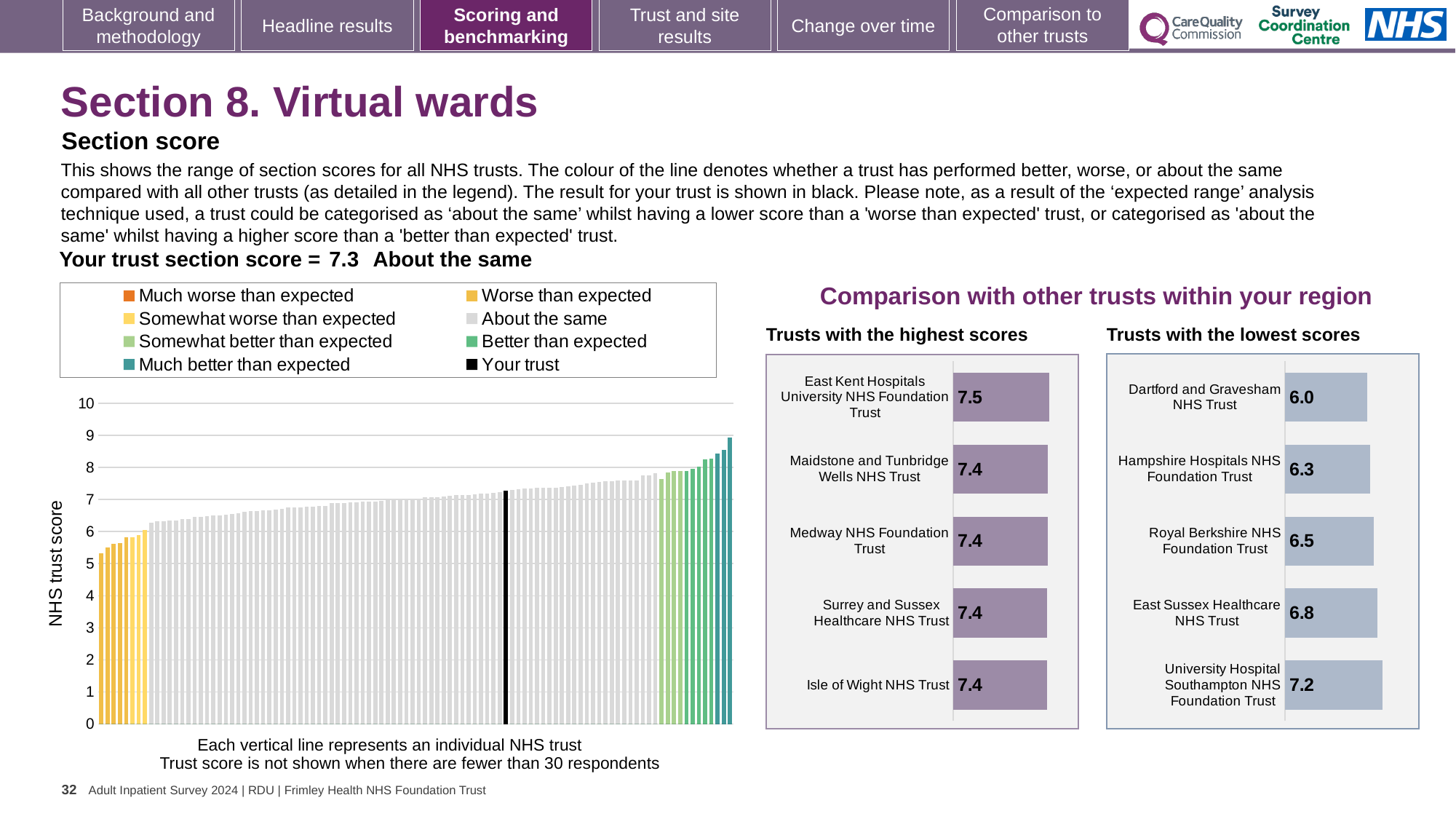
In the NHS trust score chart on the left, do the bar values rise or fall from left to right along the x axis? rise In the 'Trusts with the lowest scores' chart, which trust has the highest score? University Hospital Southampton NHS Foundation Trust What kind of chart is the NHS trust score chart on the left of the slide? bar chart In the 'Trusts with the lowest scores' chart, which has the larger score: Hampshire Hospitals NHS Foundation Trust or Royal Berkshire NHS Foundation Trust? Royal Berkshire NHS Foundation Trust In the 'Trusts with the lowest scores' chart, which trust has the lowest score? Dartford and Gravesham NHS Trust In the NHS trust score chart on the left, what is the section score for your trust (the black bar)? 7.3 In the 'Trusts with the highest scores' chart, what is the difference between the scores of East Kent Hospitals University NHS Foundation Trust and Isle of Wight NHS Trust? 0.1 In the 'Trusts with the lowest scores' chart, what is the difference between the scores of University Hospital Southampton NHS Foundation Trust and Dartford and Gravesham NHS Trust? 1.2 How many entries does the legend of the NHS trust score chart on the left list? 8 How many trusts are shown in the 'Trusts with the highest scores' chart? 5 In the 'Trusts with the lowest scores' chart, what is the score for Dartford and Gravesham NHS Trust? 6.0 In the 'Trusts with the highest scores' chart, what is the score for East Kent Hospitals University NHS Foundation Trust? 7.5